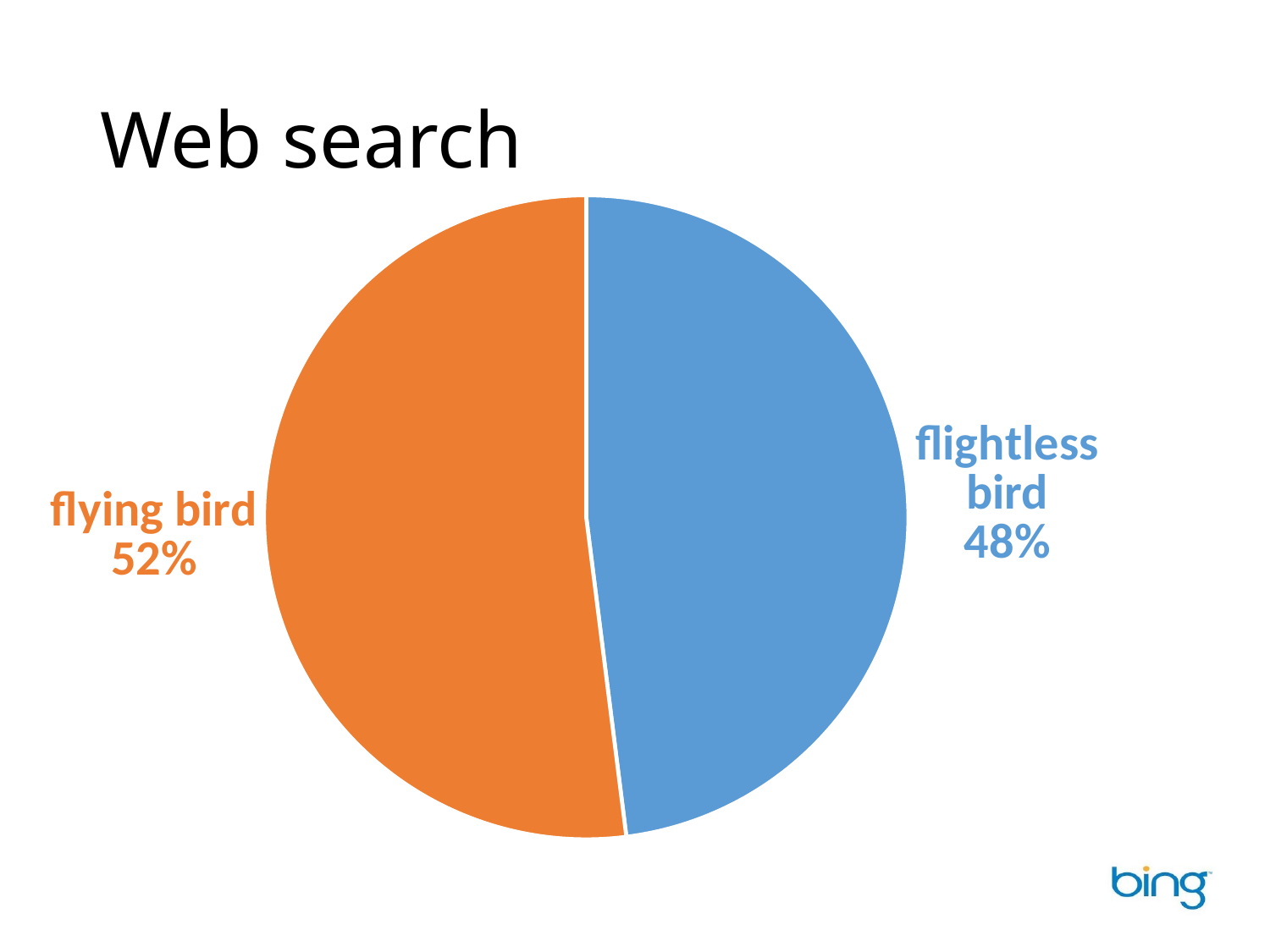
What share of the pie does "flying bird" have? 52% What share of the pie does "flightless bird" have? 48% What is the title of the slide? Web search Is the share for "flightless bird" greater or less than 50%? less How many slices does the pie chart have? 2 Which slice is the smallest? flightless bird Which is larger, the "flying bird" slice or the "flightless bird" slice? flying bird What colour is the "flying bird" slice? orange Which slice is the largest? flying bird What is the difference between the "flying bird" and "flightless bird" shares? 4% What kind of chart is shown on the slide? pie chart